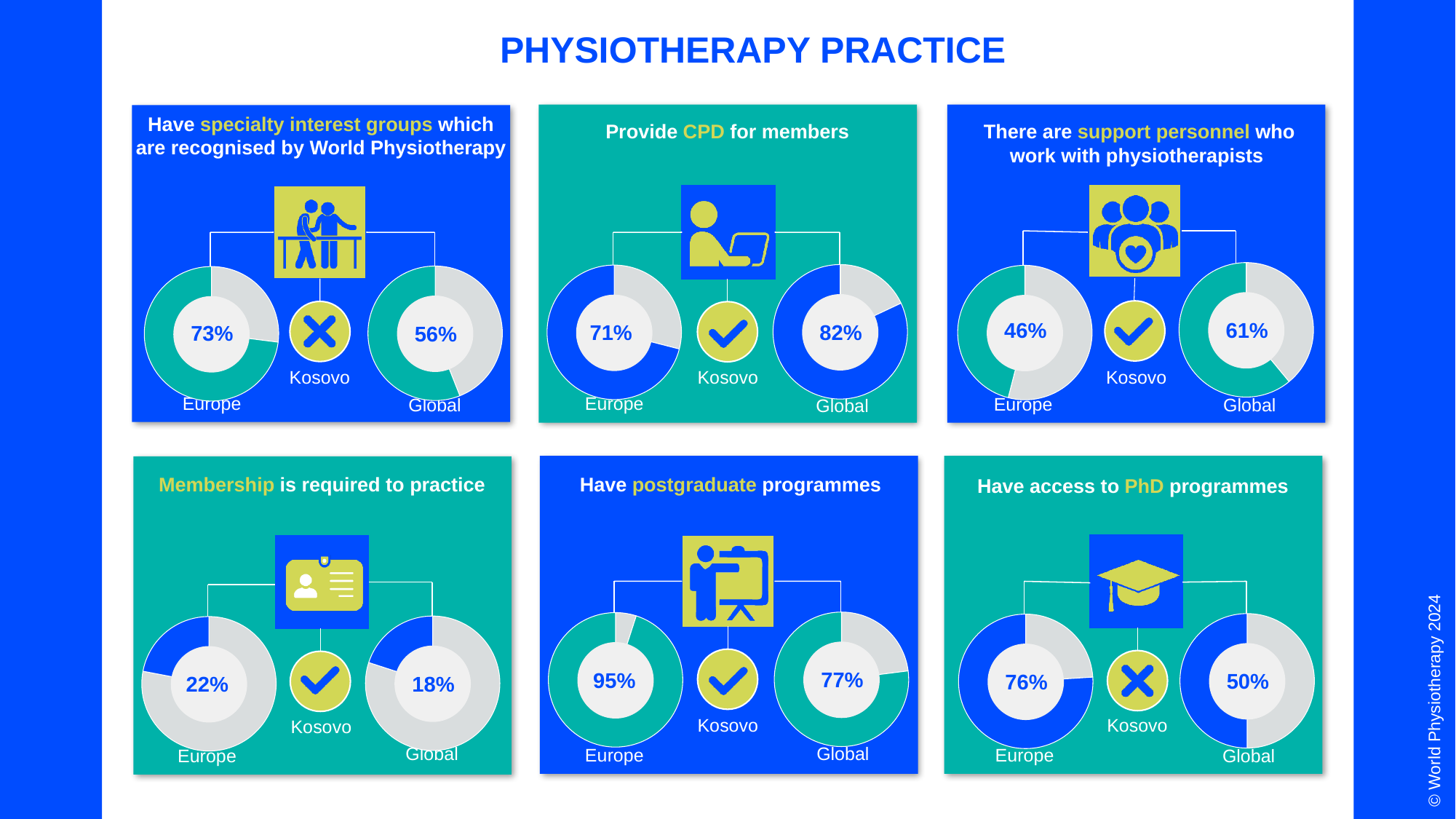
Across all six panels, which Global value is the lowest? 18% (Membership is required to practice) Across all six panels, which Europe value is the highest? 95% (Have postgraduate programmes) In the 'Have postgraduate programmes' panel, what is the difference between the Europe and Global values? 18% In the 'Have access to PhD programmes' panel, which is larger, the Europe value or the Global value? Europe In the 'Provide CPD for members' panel, which is larger, the Europe value or the Global value? Global What kind of chart is used to show the Europe and Global values in each panel? Donut chart How many donut charts are shown on the slide in total? 12 In the 'There are support personnel who work with physiotherapists' panel, what is the Europe value? 46% In the 'Membership is required to practice' panel, what is the Global value? 18% In the 'Have specialty interest groups which are recognised by World Physiotherapy' panel, what is the Europe value? 73% In the 'Have specialty interest groups which are recognised by World Physiotherapy' panel, what is the difference between the Europe and Global values? 17% In the 'Provide CPD for members' panel, what is the Global value shown in the donut chart? 82%